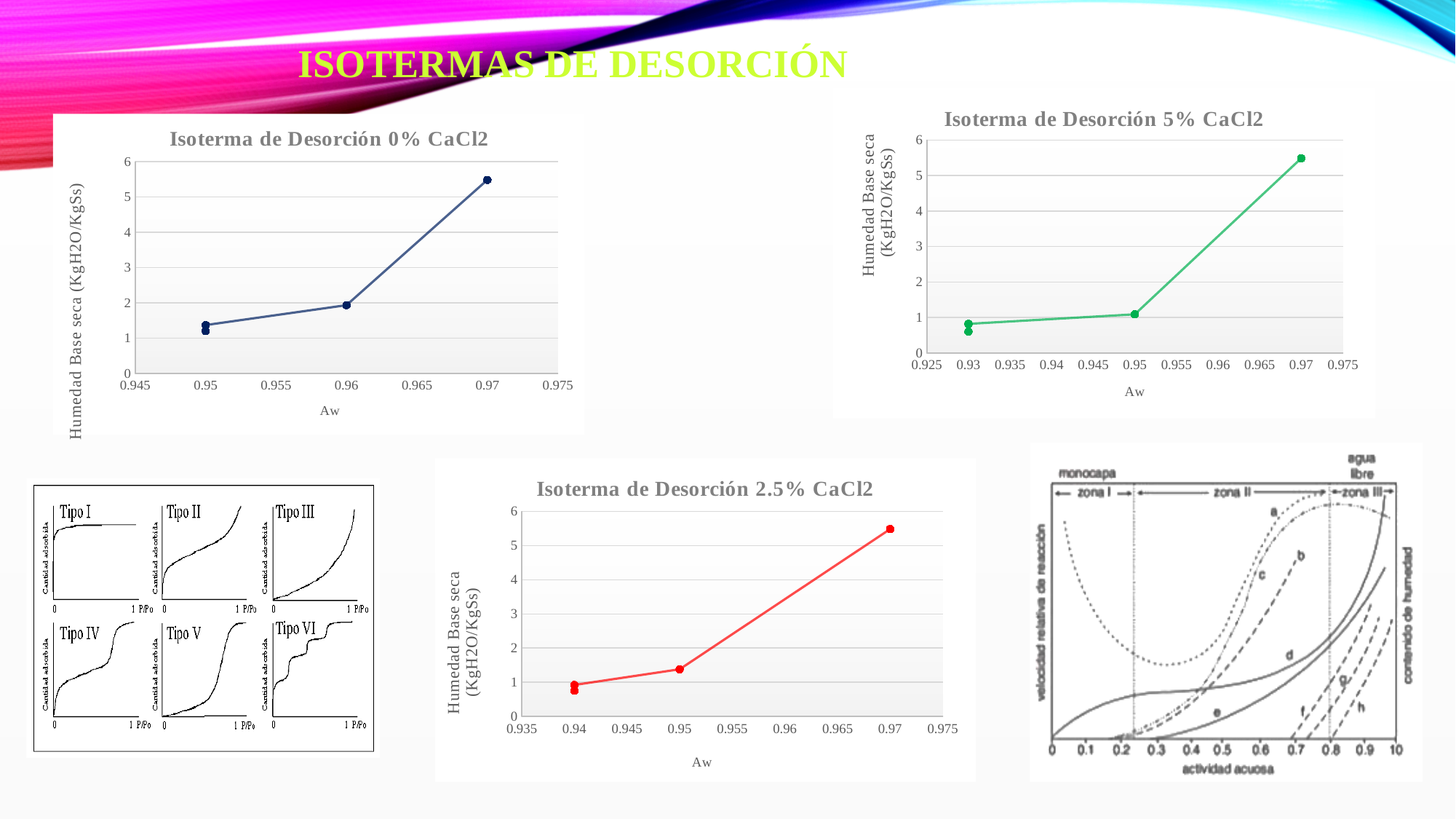
In the chart titled 'Isoterma de Desorción 0% CaCl2', at which Aw value is the humidity highest? 0.97 In the chart titled 'Isoterma de Desorción 0% CaCl2', is the value at Aw 0.97 greater or less than 5? greater What kind of chart is 'Isoterma de Desorción 5% CaCl2'? line chart In the chart titled 'Isoterma de Desorción 5% CaCl2', is the value at Aw 0.95 greater or less than 2? less In the chart titled 'Isoterma de Desorción 0% CaCl2', is the value at Aw 0.96 greater or less than 3? less In the chart titled 'Isoterma de Desorción 0% CaCl2', which has the larger value: the point at Aw 0.96 or the point at Aw 0.97? 0.97 What is the y-axis label of the chart titled 'Isoterma de Desorción 2.5% CaCl2'? Humedad Base seca (KgH2O/KgSs) In the chart titled 'Isoterma de Desorción 2.5% CaCl2', do the values rise or fall as Aw increases? rise In the chart titled 'Isoterma de Desorción 5% CaCl2', at which Aw value are the lowest points plotted? 0.93